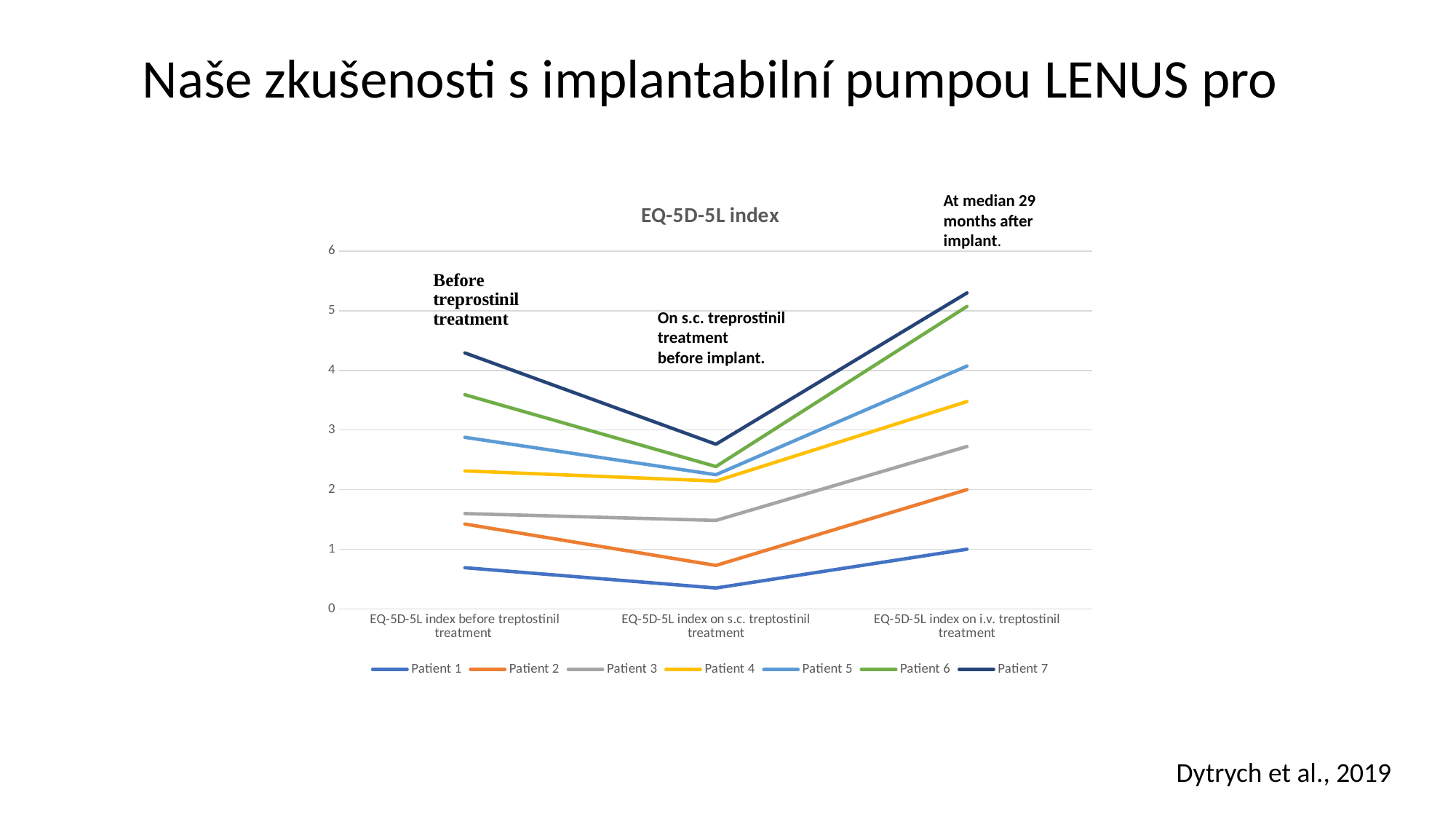
Is the value for Patient 3 on s.c. treprostinil treatment greater or less than 2? less What kind of chart is shown on the slide? line chart Is the value for Patient 7 on s.c. treprostinil treatment greater or less than 3? less Does the line for Patient 7 fall or rise between s.c. treprostinil treatment and i.v. treprostinil treatment? rise Which is larger: Patient 6 or Patient 5 on i.v. treprostinil treatment? Patient 6 What is the title of the chart? EQ-5D-5L index How many series does the legend list? 7 How many categories are shown on the x axis? 3